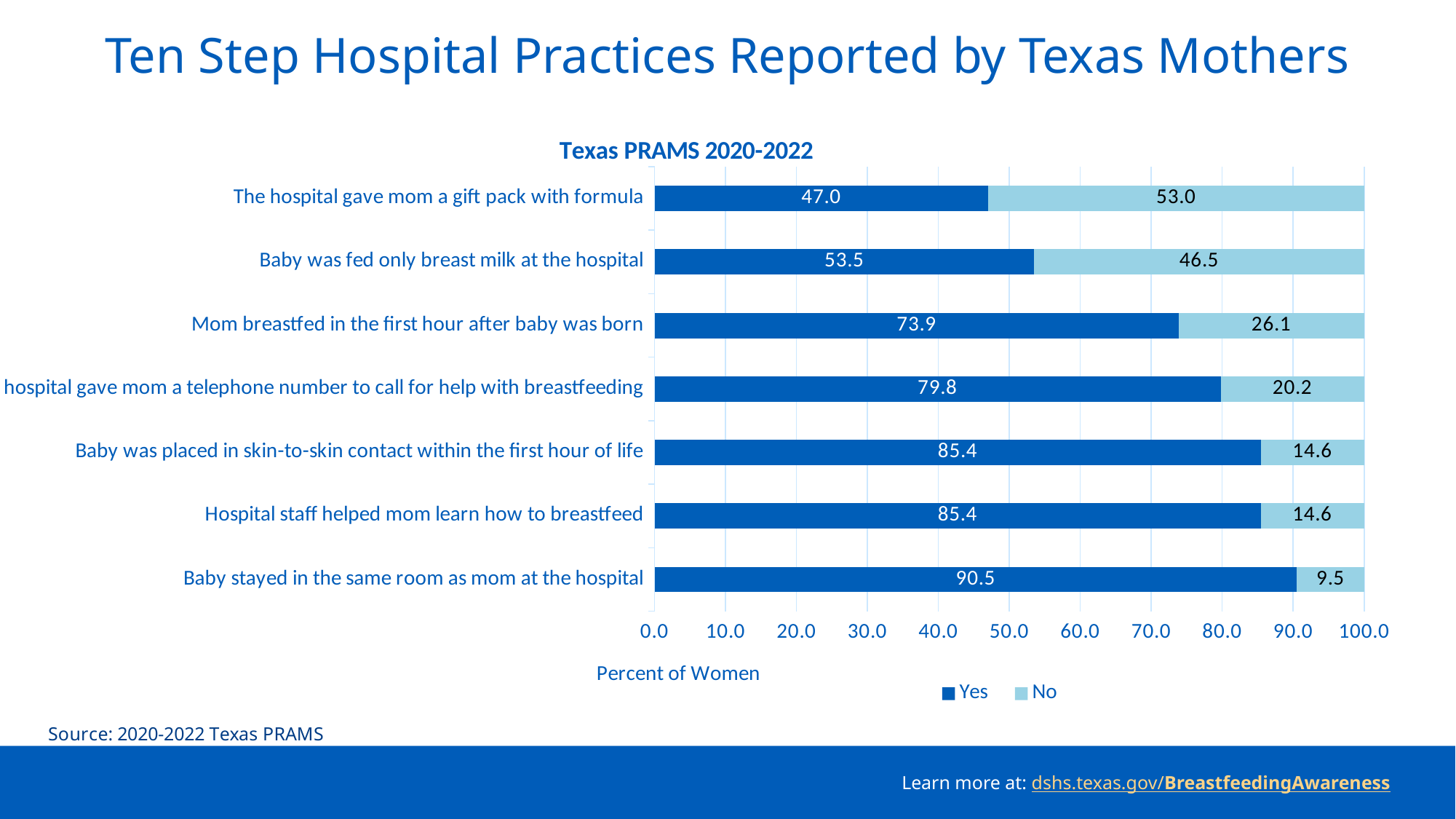
Which practice has the lowest 'Yes' value? The hospital gave mom a gift pack with formula What is the title of the chart? Texas PRAMS 2020-2022 How many practices (categories) are shown in the chart? 7 What is the difference between the 'Yes' values for 'Baby stayed in the same room as mom at the hospital' and 'Baby was fed only breast milk at the hospital'? 37.0 What is the 'No' value for 'The hospital gave mom a gift pack with formula'? 53.0 What is the 'Yes' value for 'Mom breastfed in the first hour after baby was born'? 73.9 Which practice has the highest 'Yes' value? Baby stayed in the same room as mom at the hospital What is the 'Yes' value for 'Baby stayed in the same room as mom at the hospital'? 90.5 What kind of chart is shown on the slide? Stacked bar chart How many series does the legend list? 2 What is the total of the stacked bar for 'Hospital staff helped mom learn how to breastfeed'? 100.0 Which has a larger 'No' value: 'Mom breastfed in the first hour after baby was born' or 'Baby was fed only breast milk at the hospital'? Baby was fed only breast milk at the hospital